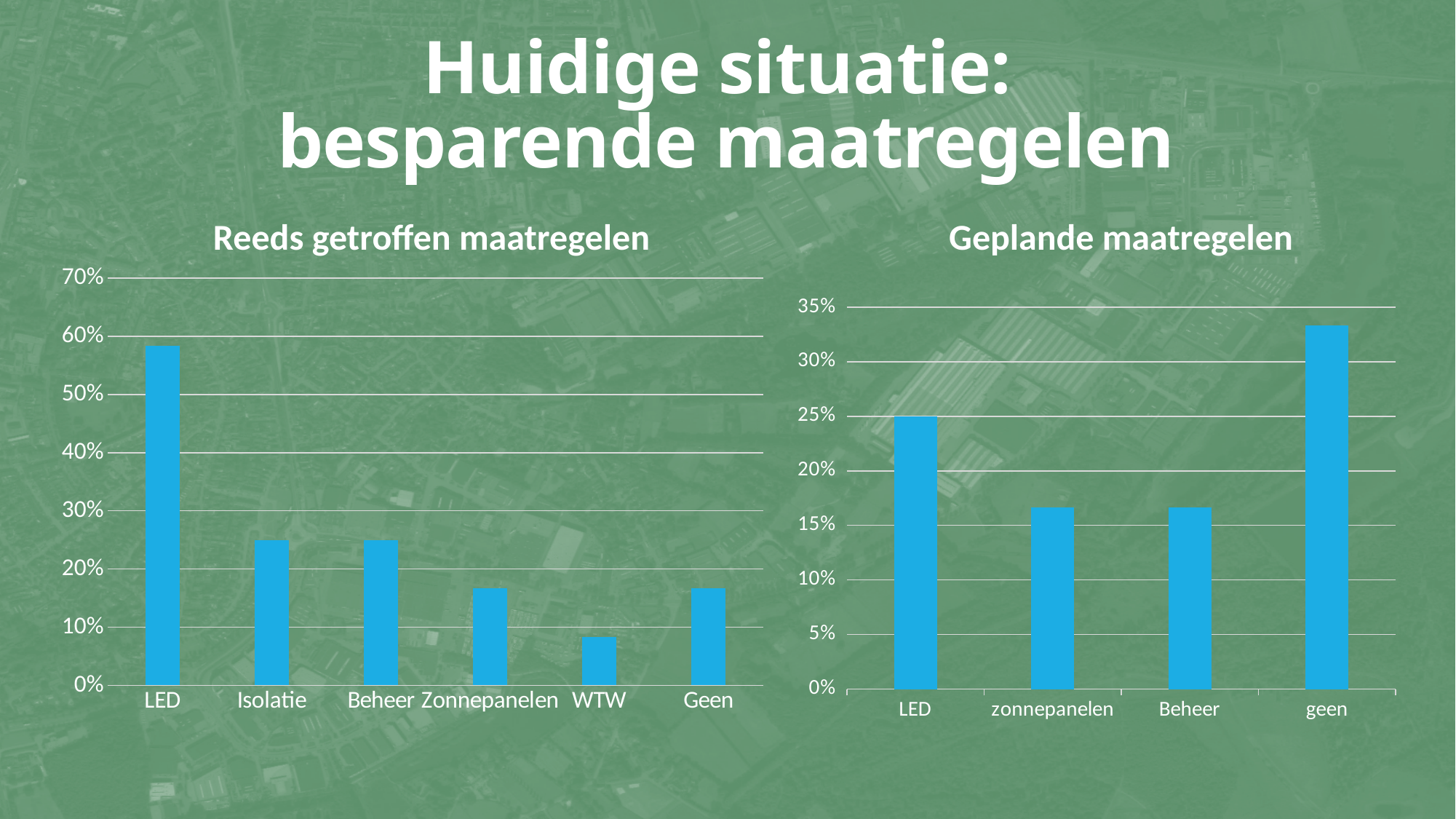
In the 'Reeds getroffen maatregelen' chart, is the value for WTW greater or less than 10%? less How many categories are shown in the 'Geplande maatregelen' chart? 4 What type of chart is the 'Reeds getroffen maatregelen' chart? bar chart In the 'Geplande maatregelen' chart, which is larger: the value for geen or the value for LED? geen How many categories are shown in the 'Reeds getroffen maatregelen' chart? 6 In the 'Reeds getroffen maatregelen' chart, is the value for Isolatie greater or less than 20%? greater In the 'Reeds getroffen maatregelen' chart, is the value for LED greater or less than 50%? greater In the 'Geplande maatregelen' chart, which category has the highest value? geen In the 'Reeds getroffen maatregelen' chart, which category has the lowest value? WTW In the 'Reeds getroffen maatregelen' chart, which category has the highest value? LED In the 'Geplande maatregelen' chart, what is the value for LED? 25%